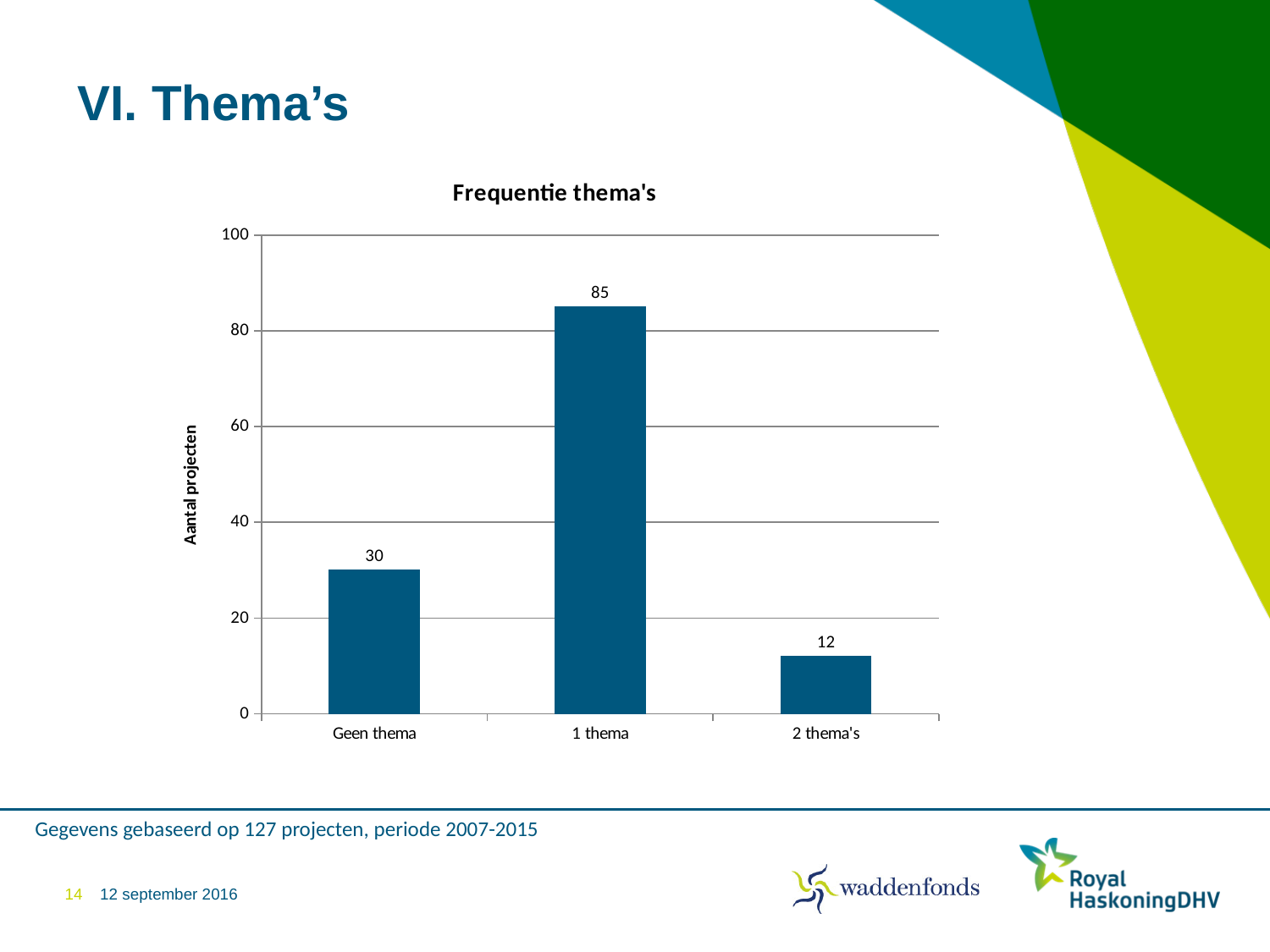
What is the difference between the values for '1 thema' and 'Geen thema'? 55 What is the difference between the values for 'Geen thema' and '2 thema's'? 18 Which is larger, the value for 'Geen thema' or the value for '2 thema's'? Geen thema What is the value for '1 thema'? 85 Which category has the highest value? 1 thema What is the value for 'Geen thema'? 30 What kind of chart is shown on the slide? bar chart Which category has the lowest value? 2 thema's What is the value for '2 thema's'? 12 Is the value for '1 thema' greater or less than 80? greater What is the title of the chart? Frequentie thema's How many categories are shown on the x axis? 3